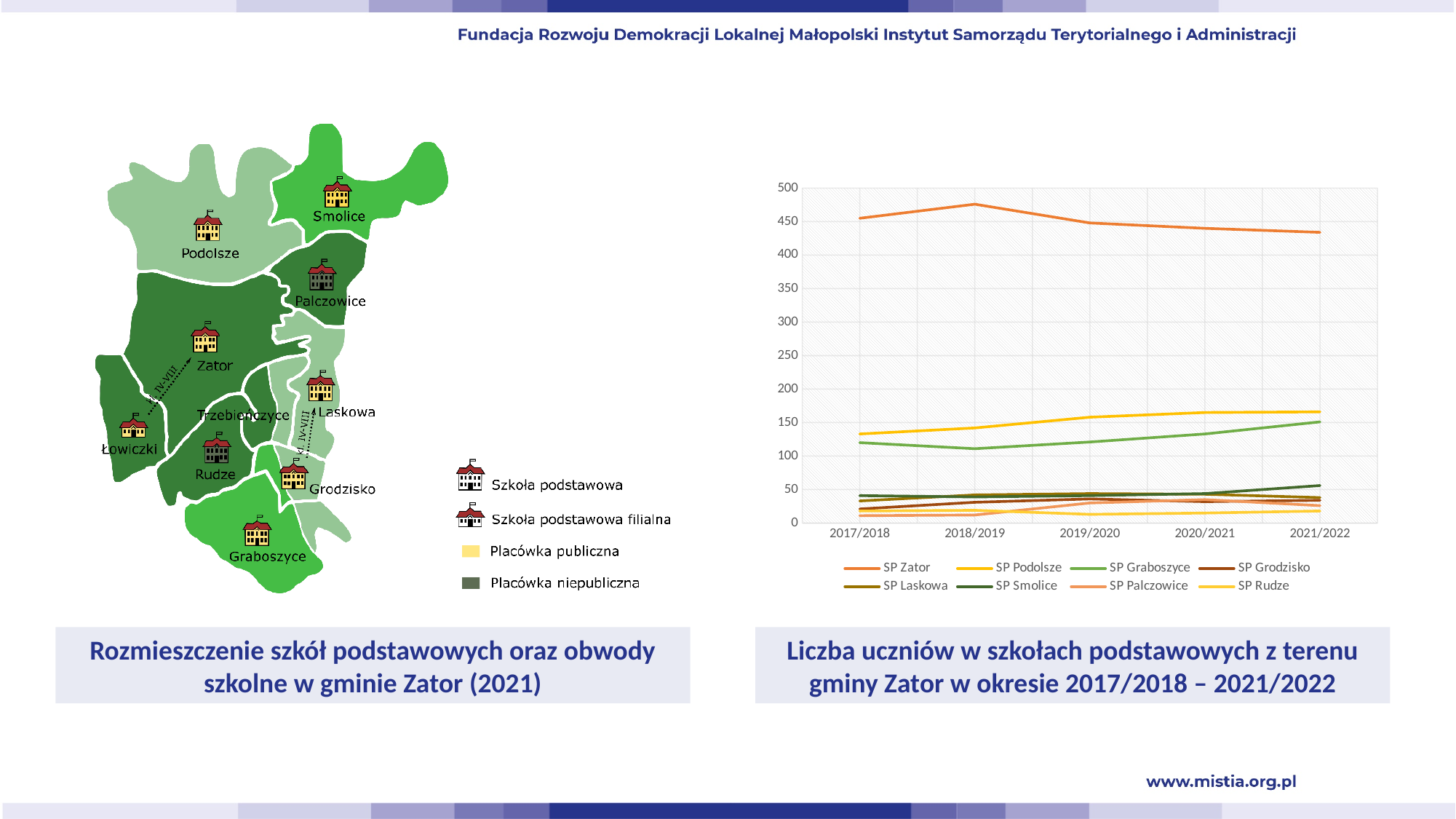
In the line chart on the right, does the value for SP Podolsze rise or fall from 2017/2018 to 2021/2022? rise In the line chart on the right, how many school years are shown on the x axis? 5 In the line chart on the right, which is larger in 2019/2020: SP Podolsze or SP Graboszyce? SP Podolsze What is the title given below the line chart on the right? Liczba uczniów w szkołach podstawowych z terenu gminy Zator w okresie 2017/2018 – 2021/2022 In the line chart on the right, is the value for SP Graboszyce in 2018/2019 greater or less than 150? less In the line chart on the right, what is the first school year shown on the x axis? 2017/2018 What kind of chart is shown on the right side of the slide? line chart In the line chart on the right, which school has the highest number of pupils in 2021/2022? SP Zator In the line chart on the right, is the value for SP Zator in 2018/2019 greater or less than 450? greater In the line chart on the right, how many series does the legend list? 8 In the line chart on the right, does the value for SP Zator rise or fall from 2018/2019 to 2021/2022? fall In the line chart on the right, is the value for SP Podolsze in 2021/2022 greater or less than 150? greater